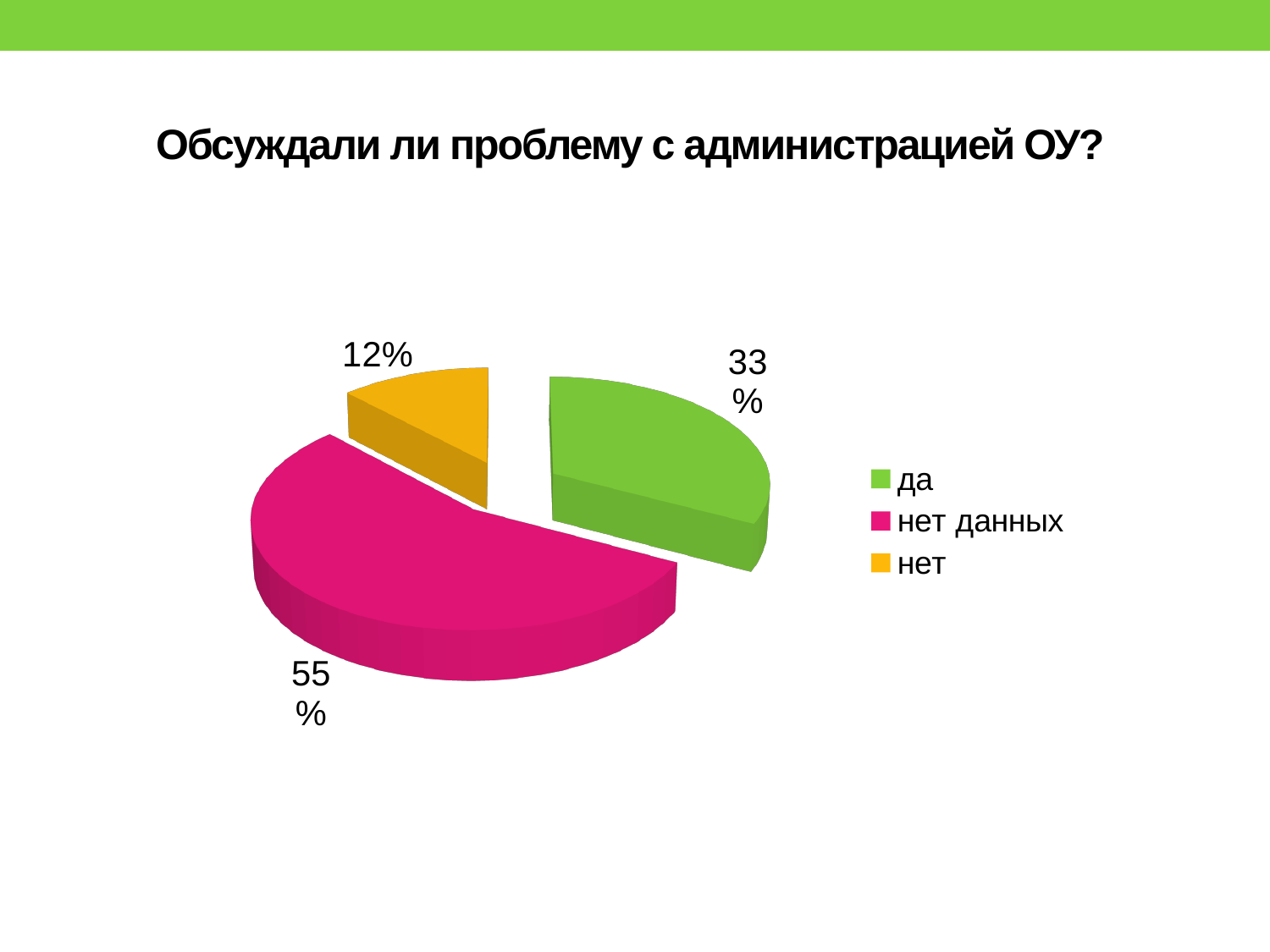
What is the title of the slide above the chart? Обсуждали ли проблему с администрацией ОУ? Which category has the largest slice of the pie? нет данных How many categories are shown in the pie chart? 3 What is the difference in percentage points between "да" and "нет"? 21 What kind of chart is shown on the slide? pie chart What share of the pie does "да" represent? 33% Which category has the smallest slice of the pie? нет What is the difference in percentage points between "нет данных" and "да"? 22 What colour is the slice for "нет данных"? pink (magenta) What share of the pie does "нет" represent? 12% Which is larger, the share for "да" or the share for "нет"? да What share of the pie does "нет данных" represent? 55%